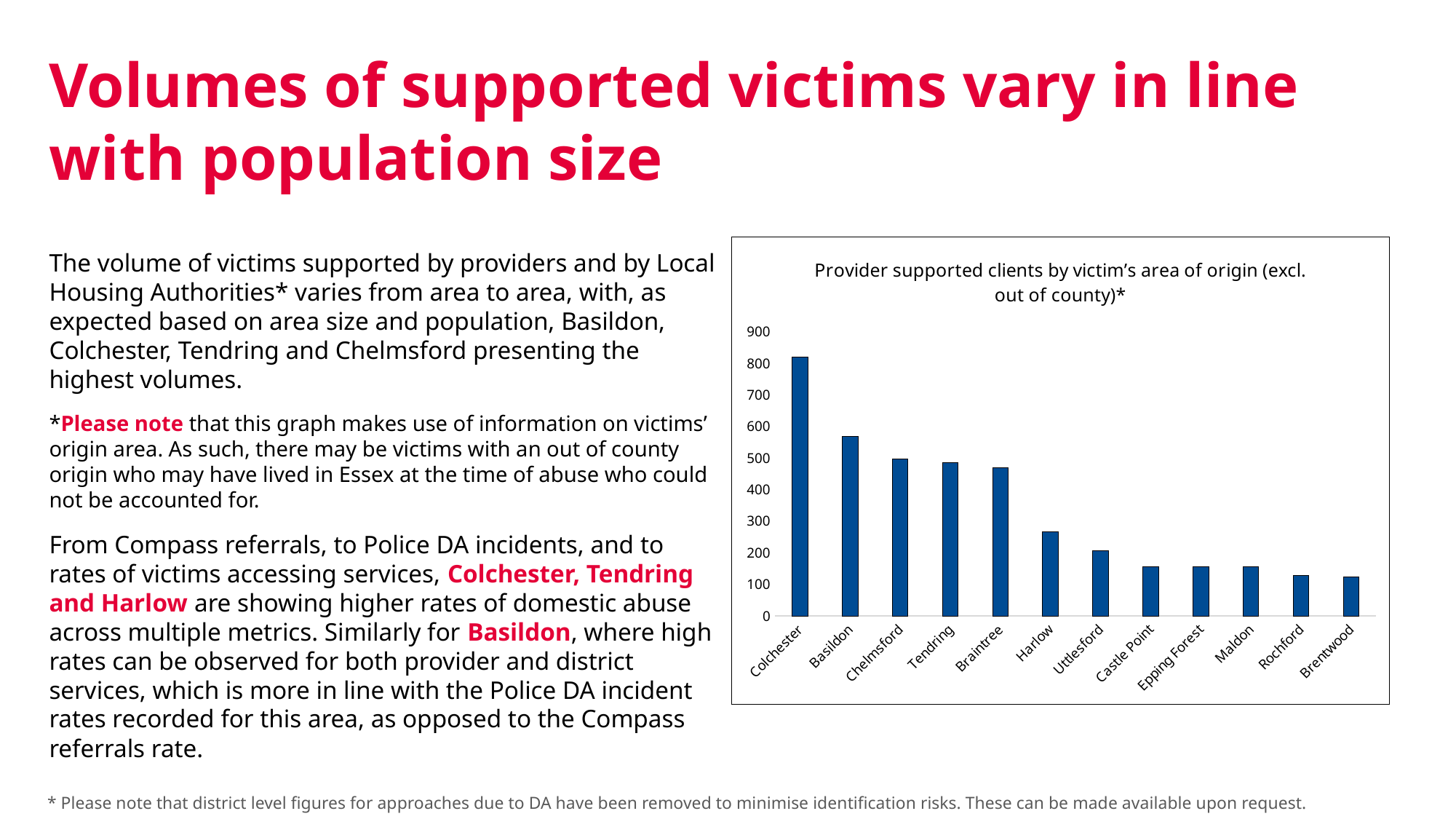
Which has a higher value, Colchester or Basildon? Colchester Do the values generally rise or fall moving from left to right along the x axis? Fall Which has a higher value, Harlow or Uttlesford? Harlow Which area has the highest number of provider supported clients? Colchester Is the value for Harlow greater or less than 300? less What is the title of the chart? Provider supported clients by victim's area of origin (excl. out of county)* Is the value for Brentwood greater or less than 100? greater How many areas are shown on the x axis of the chart? 12 Is the value for Basildon greater or less than 500? greater What kind of chart is shown on the slide? Bar chart Which has a higher value, Braintree or Harlow? Braintree